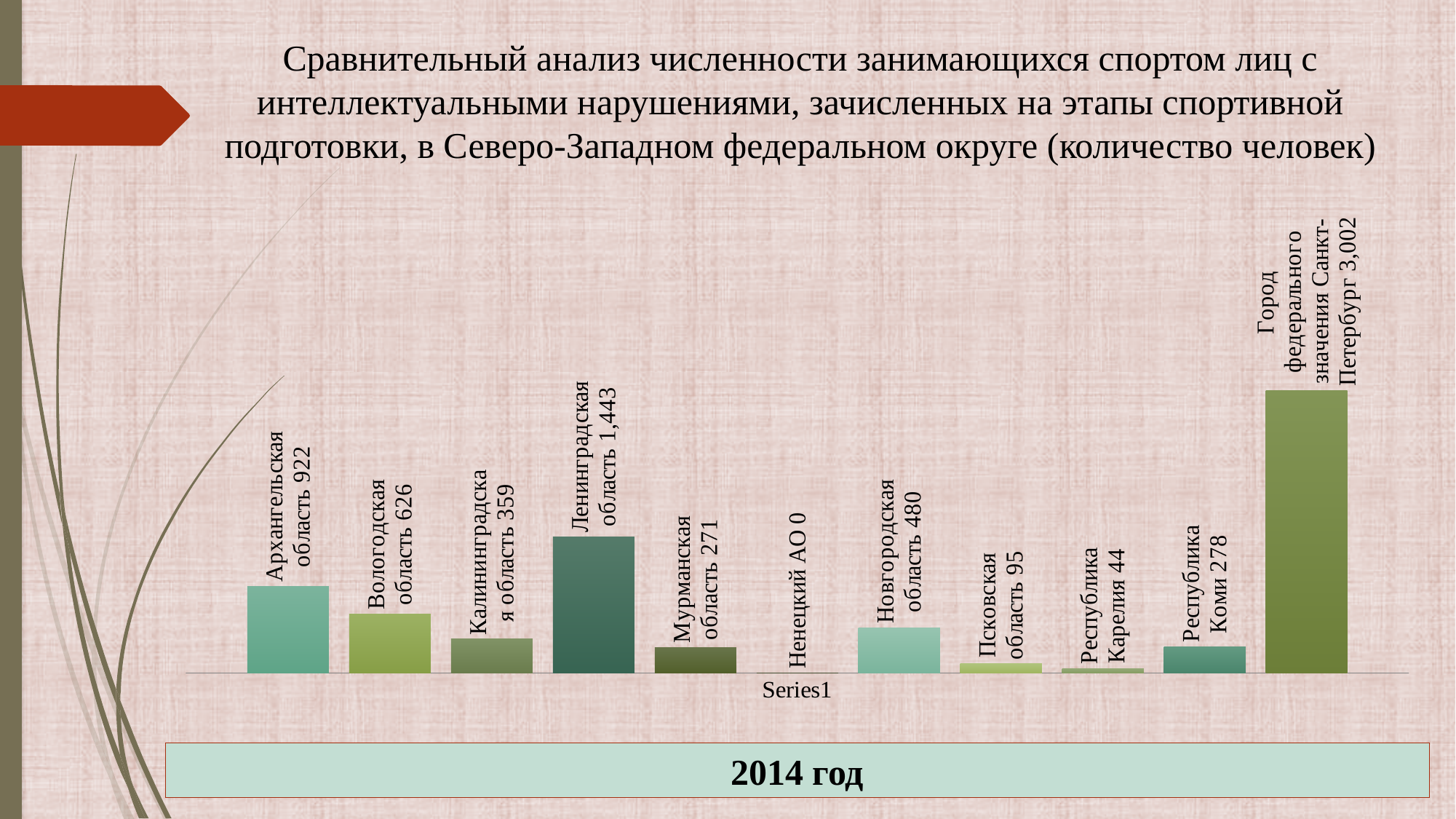
What is the difference between the values for Архангельская область and Вологодская область? 296 What is the value for Город федерального значения Санкт-Петербург? 3,002 What is the difference between the values for Санкт-Петербург and Ленинградская область? 1,559 What is the value for Республика Карелия? 44 How many categories are shown in the chart? 11 What year does the chart refer to, according to the box below it? 2014 год Which category has the highest value? Город федерального значения Санкт-Петербург Which is larger, the value for Мурманская область or the value for Республика Коми? Республика Коми What is the value for Архангельская область? 922 What kind of chart is shown on the slide? Bar chart Which category has the lowest value? Ненецкий АО What is the value for Ленинградская область? 1,443